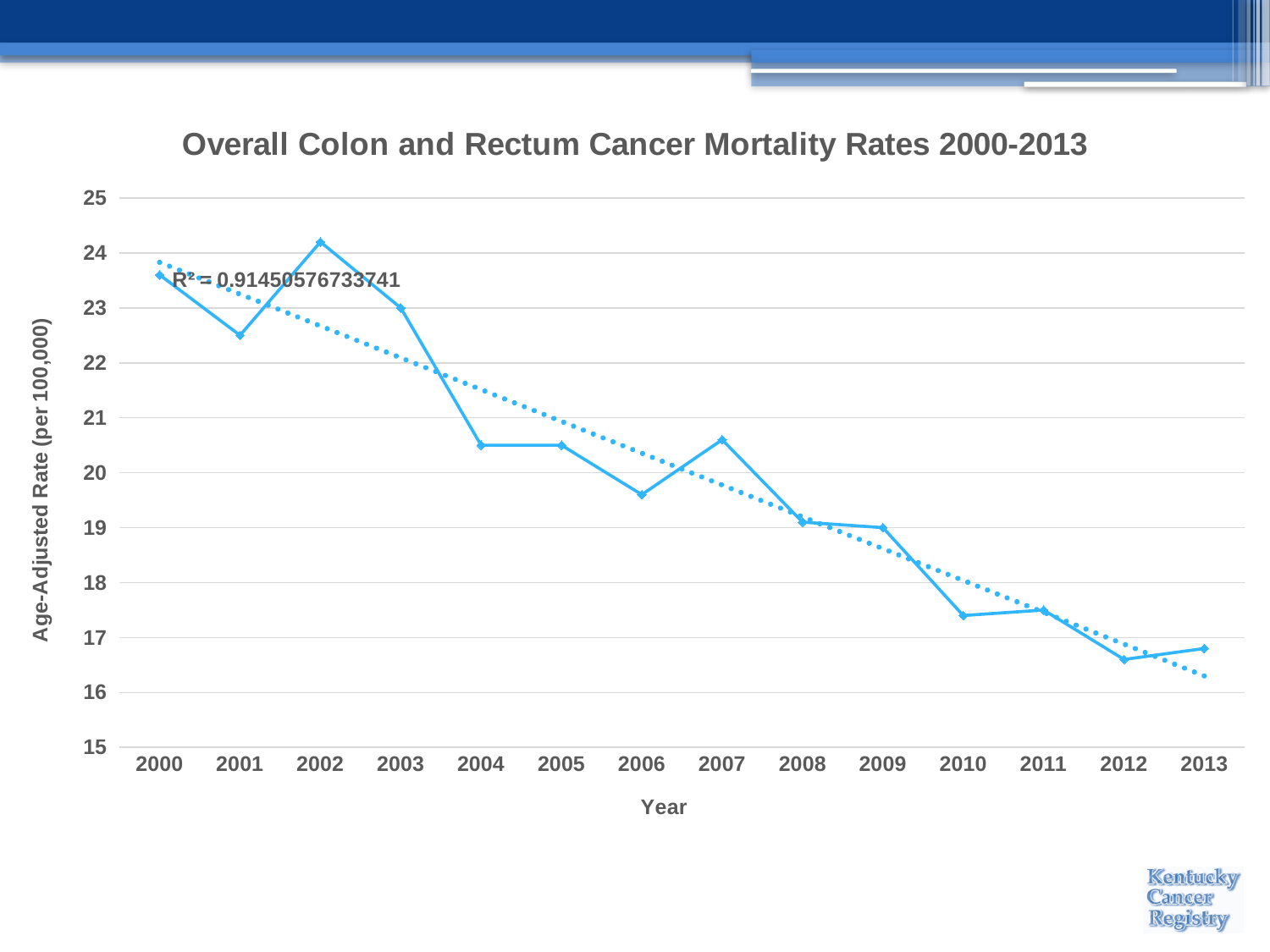
What is the title of the chart? Overall Colon and Rectum Cancer Mortality Rates 2000-2013 Do the mortality rates generally rise or fall from 2000 to 2013? fall Is the value for 2013 greater or less than 17? less Which year has the highest mortality rate? 2002 Is the value for 2002 greater or less than 24? greater Which year has the lowest mortality rate? 2012 What R² value is printed on the chart for the trend line? R² = 0.91450576733741 Which year has the higher mortality rate, 2000 or 2001? 2000 How many years are plotted on the x axis? 14 Is the value for 2004 greater or less than 20? greater What kind of chart is shown on the slide? line chart